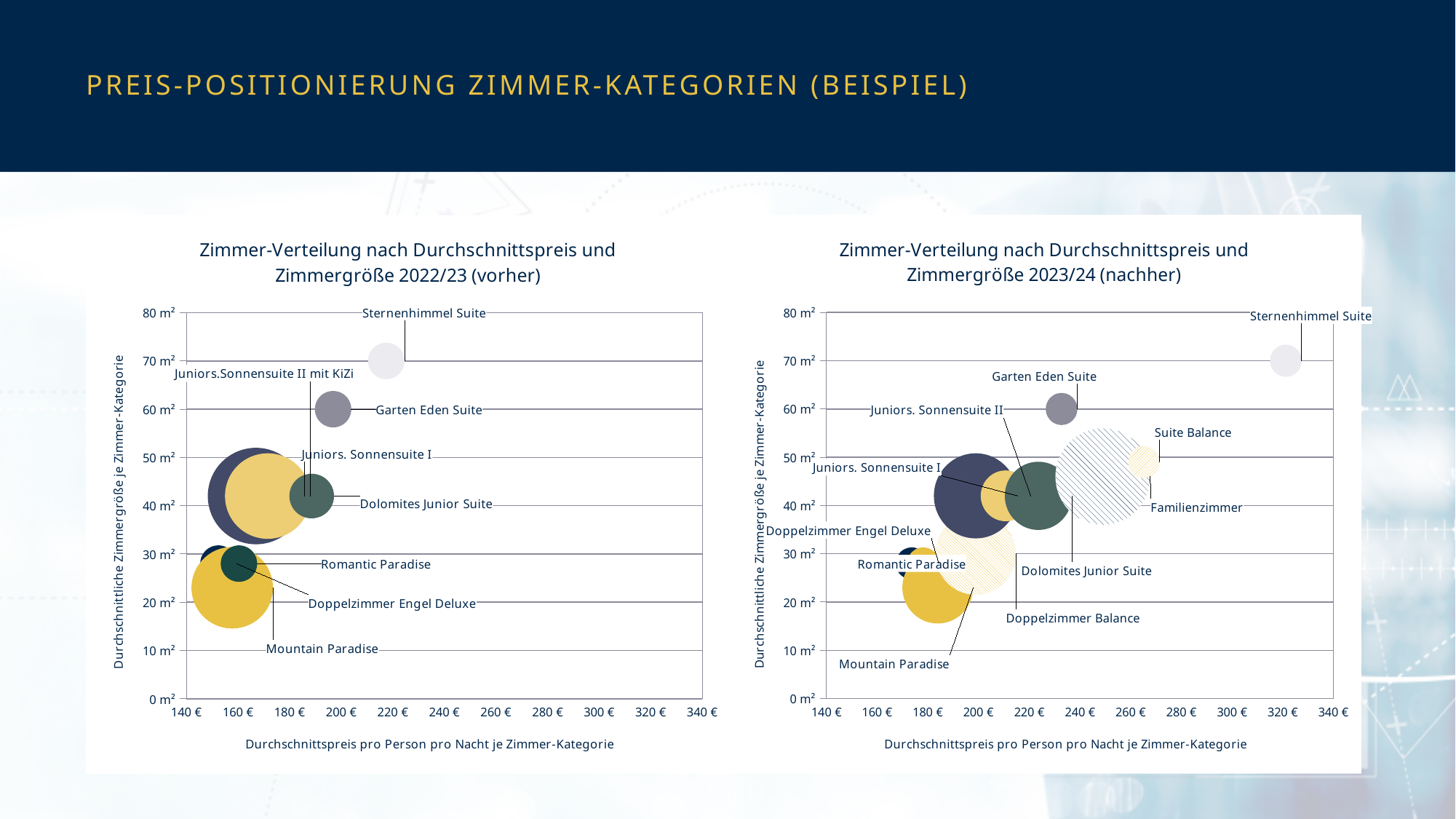
In the left chart (2022/23 vorher), which room category has the highest average price? Sternenhimmel Suite In the left chart (2022/23 vorher), is the average price of the Sternenhimmel Suite greater or less than 200 €? greater In the left chart (2022/23 vorher), which room category has the smallest average room size? Mountain Paradise In the left chart (2022/23 vorher), is the average price of Mountain Paradise greater or less than 180 €? less In the right chart (2023/24 nachher), is the average room size of the Garten Eden Suite greater or less than 50 m²? greater What is the x-axis title of the right chart (2023/24 nachher)? Durchschnittspreis pro Person pro Nacht je Zimmer-Kategorie How many room categories are plotted in the right chart (2023/24 nachher)? 11 What kind of chart is the left chart, 'Zimmer-Verteilung nach Durchschnittspreis und Zimmergröße 2022/23 (vorher)'? Bubble chart How many room categories are plotted in the left chart (2022/23 vorher)? 8 In the right chart (2023/24 nachher), which has the higher average price: the Sternenhimmel Suite or the Garten Eden Suite? Sternenhimmel Suite In the right chart (2023/24 nachher), which room category has the largest average room size? Sternenhimmel Suite